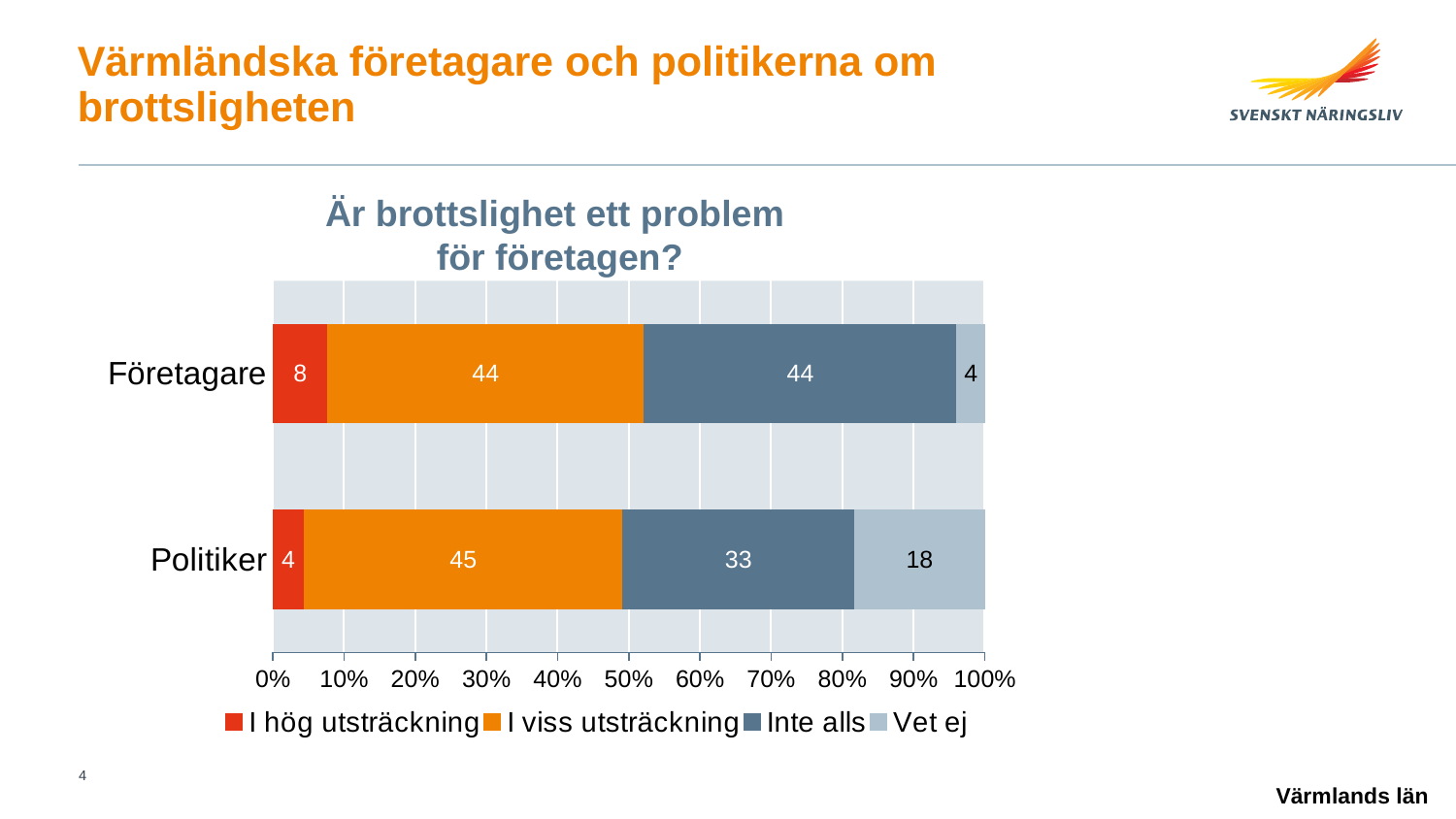
What kind of chart is shown on the slide? Stacked bar chart What is the title of the chart? Är brottslighet ett problem för företagen? How many categories are shown on the y axis of the chart? 2 What is the value for "Vet ej" for Politiker? 18 What is the difference between the "Vet ej" values for Politiker and Företagare? 14 Which category has the higher value for "Vet ej", Företagare or Politiker? Politiker Which category has the higher value for "Inte alls", Företagare or Politiker? Företagare What is the value for "I hög utsträckning" for Politiker? 4 How many series does the legend list? 4 What is the difference between the "Inte alls" values for Företagare and Politiker? 11 What is the value for "I viss utsträckning" for Företagare? 44 What is the value for "Inte alls" for Företagare? 44